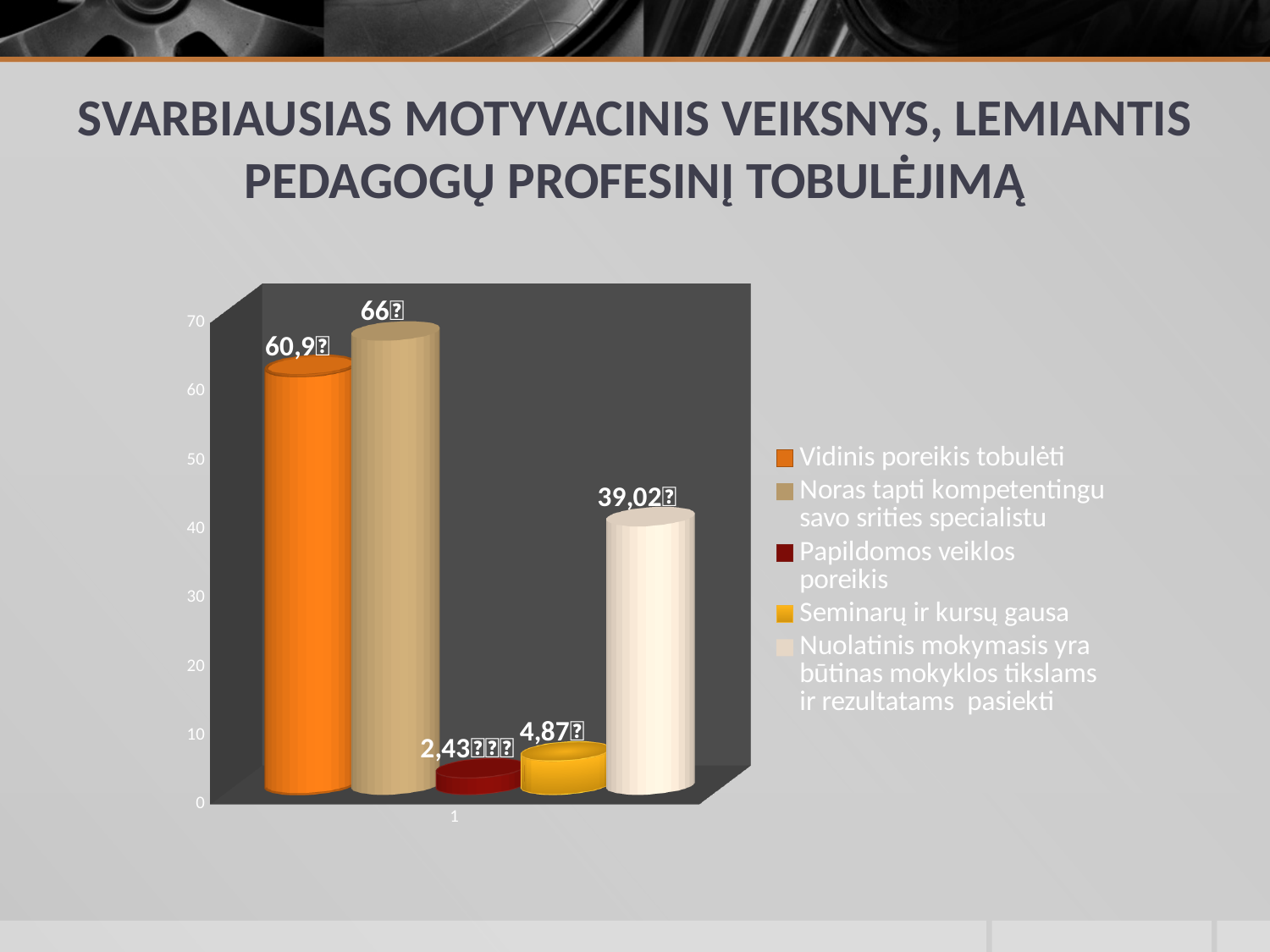
What value is shown for "Nuolatinis mokymasis yra būtinas mokyklos tikslams ir rezultatams pasiekti"? 39,02 What value is shown for "Noras tapti kompetentingu savo srities specialistu"? 66 What value is shown for "Seminarų ir kursų gausa"? 4,87 Is the value for "Nuolatinis mokymasis yra būtinas mokyklos tikslams ir rezultatams pasiekti" greater or less than 40? less Which series has the lowest value? Papildomos veiklos poreikis What is the difference between the values for "Noras tapti kompetentingu savo srities specialistu" and "Vidinis poreikis tobulėti"? 5,1 Which is larger: the value for "Seminarų ir kursų gausa" or for "Papildomos veiklos poreikis"? Seminarų ir kursų gausa What value is shown for "Vidinis poreikis tobulėti"? 60,9 How many series does the legend list? 5 What kind of chart is shown on the slide? bar chart Which series has the highest value? Noras tapti kompetentingu savo srities specialistu What value is shown for "Papildomos veiklos poreikis"? 2,43